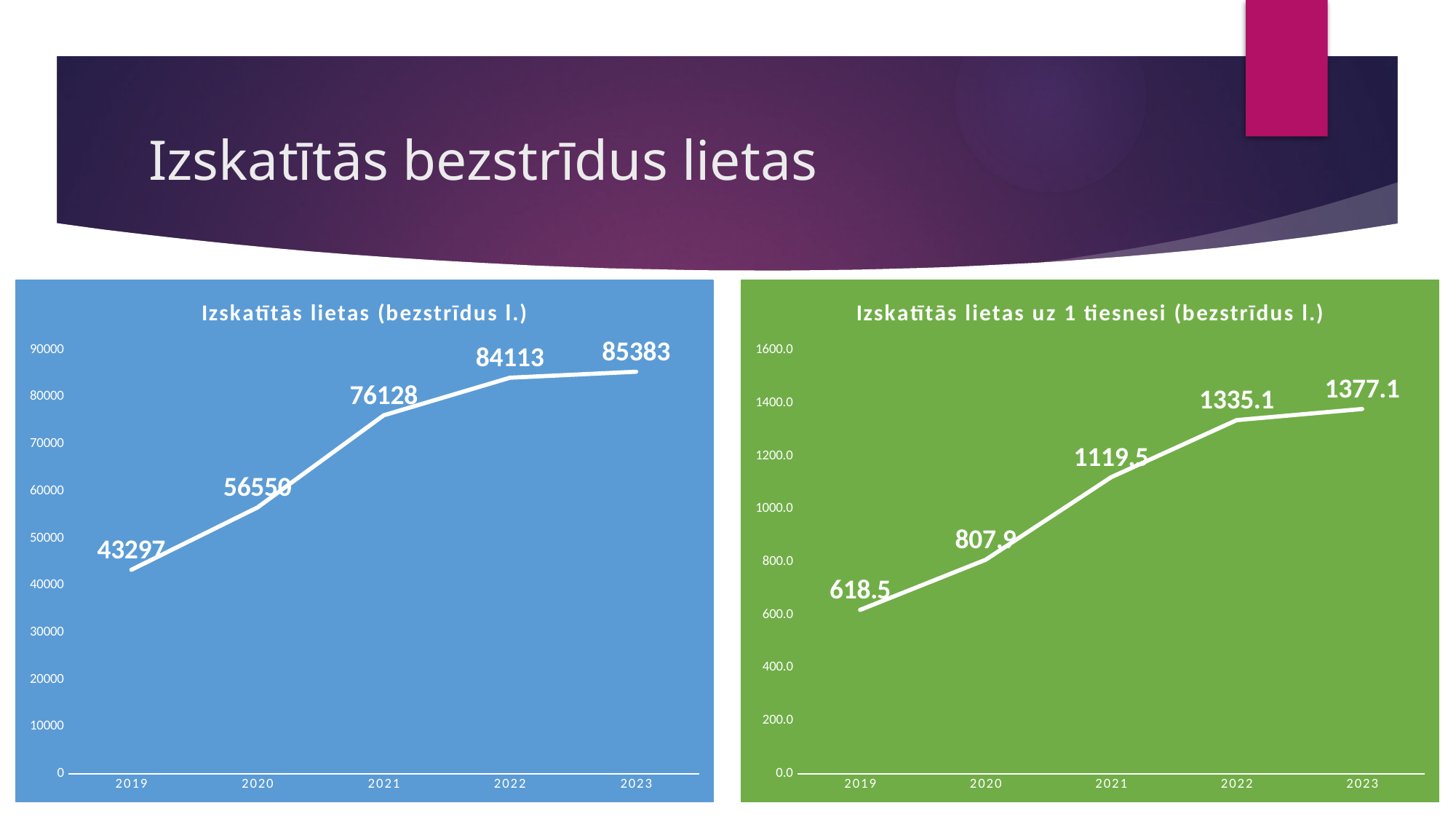
In the chart titled "Izskatītās lietas (bezstrīdus l.)", what is the difference between the 2023 and 2019 values? 42086 In the chart titled "Izskatītās lietas (bezstrīdus l.)", what is the value for 2021? 76128 In the chart titled "Izskatītās lietas uz 1 tiesnesi (bezstrīdus l.)", what is the value for 2020? 807.9 In the chart titled "Izskatītās lietas uz 1 tiesnesi (bezstrīdus l.)", what is the difference between the 2022 and 2021 values? 215.6 In the left chart, which is larger: the value for 2020 or the value for 2021? 2021 In the left chart, do the values rise or fall from 2019 to 2023? rise In the right chart, is the value for 2021 greater or less than 1000.0? greater In the right chart, which year has the lowest value? 2019 How many years are plotted in the chart titled "Izskatītās lietas (bezstrīdus l.)"? 5 What kind of chart is the chart titled "Izskatītās lietas uz 1 tiesnesi (bezstrīdus l.)"? line chart What is the title of the chart on the right side of the slide? Izskatītās lietas uz 1 tiesnesi (bezstrīdus l.) In the left chart, which year has the highest value? 2023